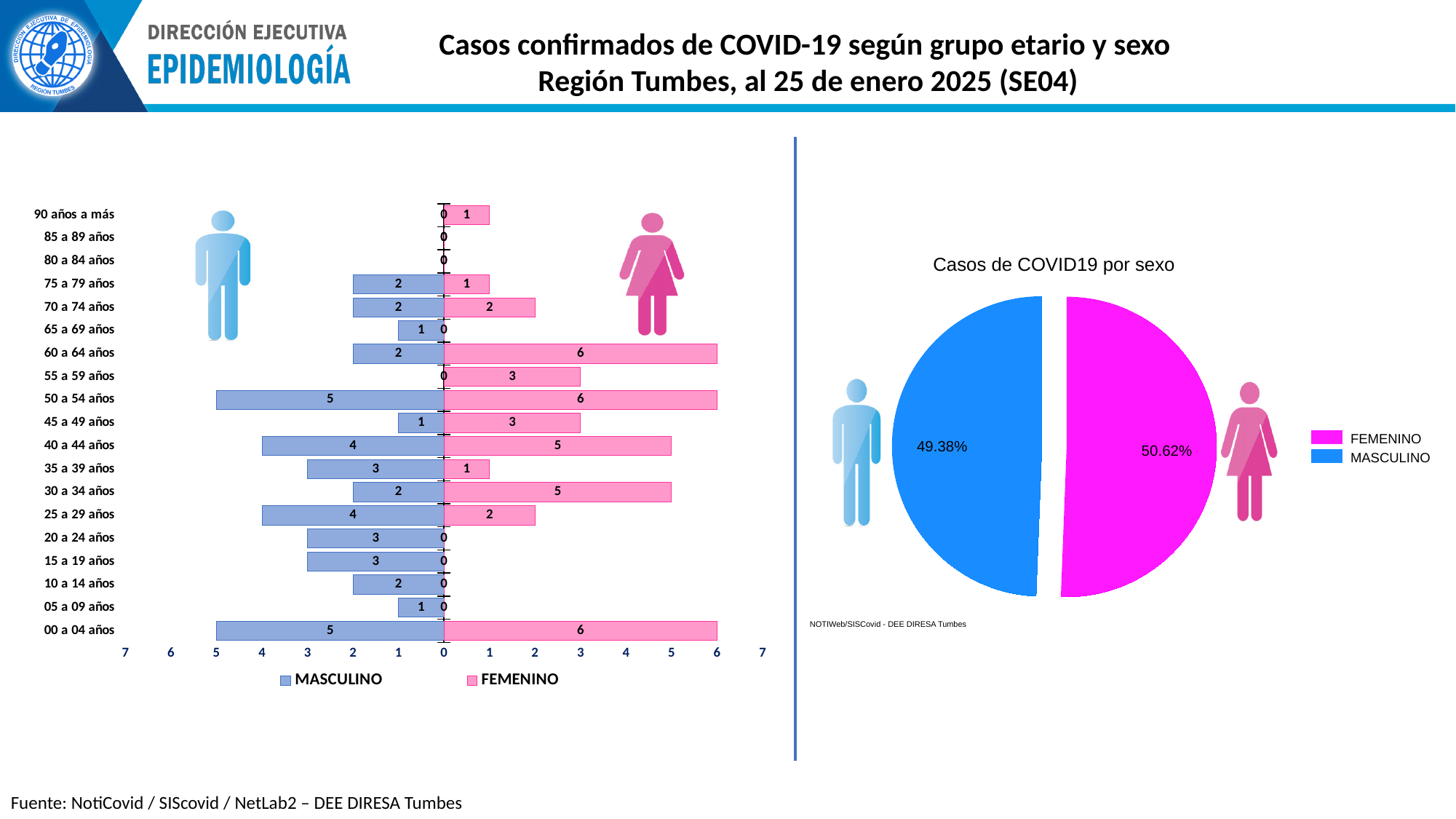
In the left chart, how many MASCULINO cases are in the 25 a 29 años group? 4 In the left chart, what is the difference between FEMENINO and MASCULINO cases in the 60 a 64 años group? 4 In the left chart, which is larger in the 35 a 39 años group, MASCULINO or FEMENINO? MASCULINO How many series does the legend of the left chart list? 2 In the pie chart 'Casos de COVID19 por sexo', which slice is the largest? FEMENINO In the left chart, how many FEMENINO cases are in the 30 a 34 años group? 5 In the left chart, how many FEMENINO cases are in the 60 a 64 años group? 6 In the left chart, how many MASCULINO cases are in the 50 a 54 años group? 5 How many age groups are shown in the left chart? 19 In the left chart, what is the total number of cases (MASCULINO plus FEMENINO) in the 00 a 04 años group? 11 What type of chart is the left chart? Bar chart In the pie chart 'Casos de COVID19 por sexo', what share is FEMENINO? 50.62%